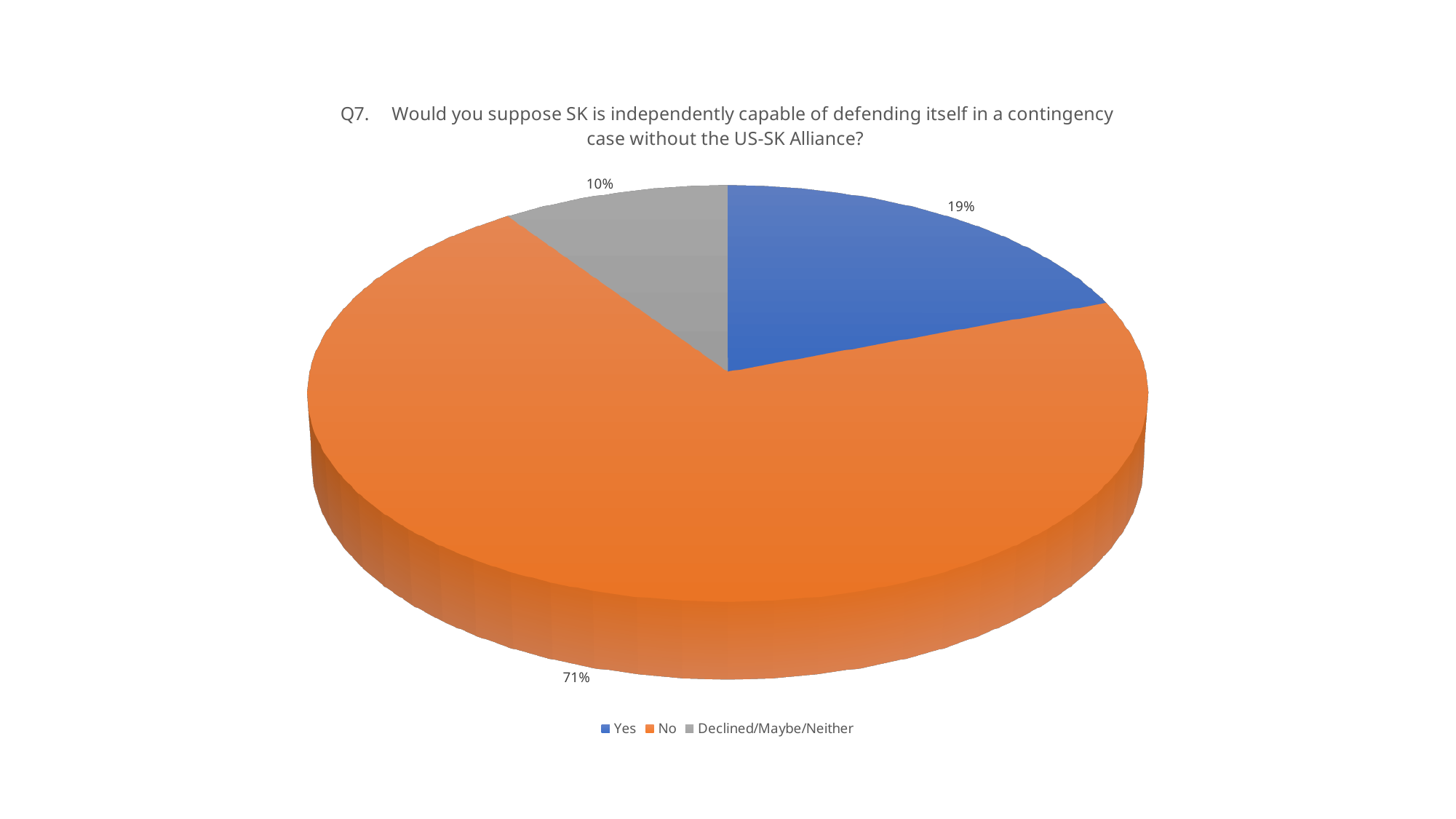
What kind of chart is shown on the slide? Pie chart Which is larger, the share for "Yes" or the share for "Declined/Maybe/Neither"? Yes How many categories does the pie chart show? 3 What percentage of respondents answered "Yes"? 19% What is the combined share of "Yes" and "Declined/Maybe/Neither"? 29% What colour is the slice representing "No"? Orange What is the difference in percentage points between the "Yes" and "Declined/Maybe/Neither" shares? 9 What percentage of respondents answered "No"? 71% Which response category has the smallest share of the pie? Declined/Maybe/Neither Which response category has the largest share of the pie? No What is the difference in percentage points between the "No" and "Yes" shares? 52 What percentage of respondents are in the "Declined/Maybe/Neither" category? 10%